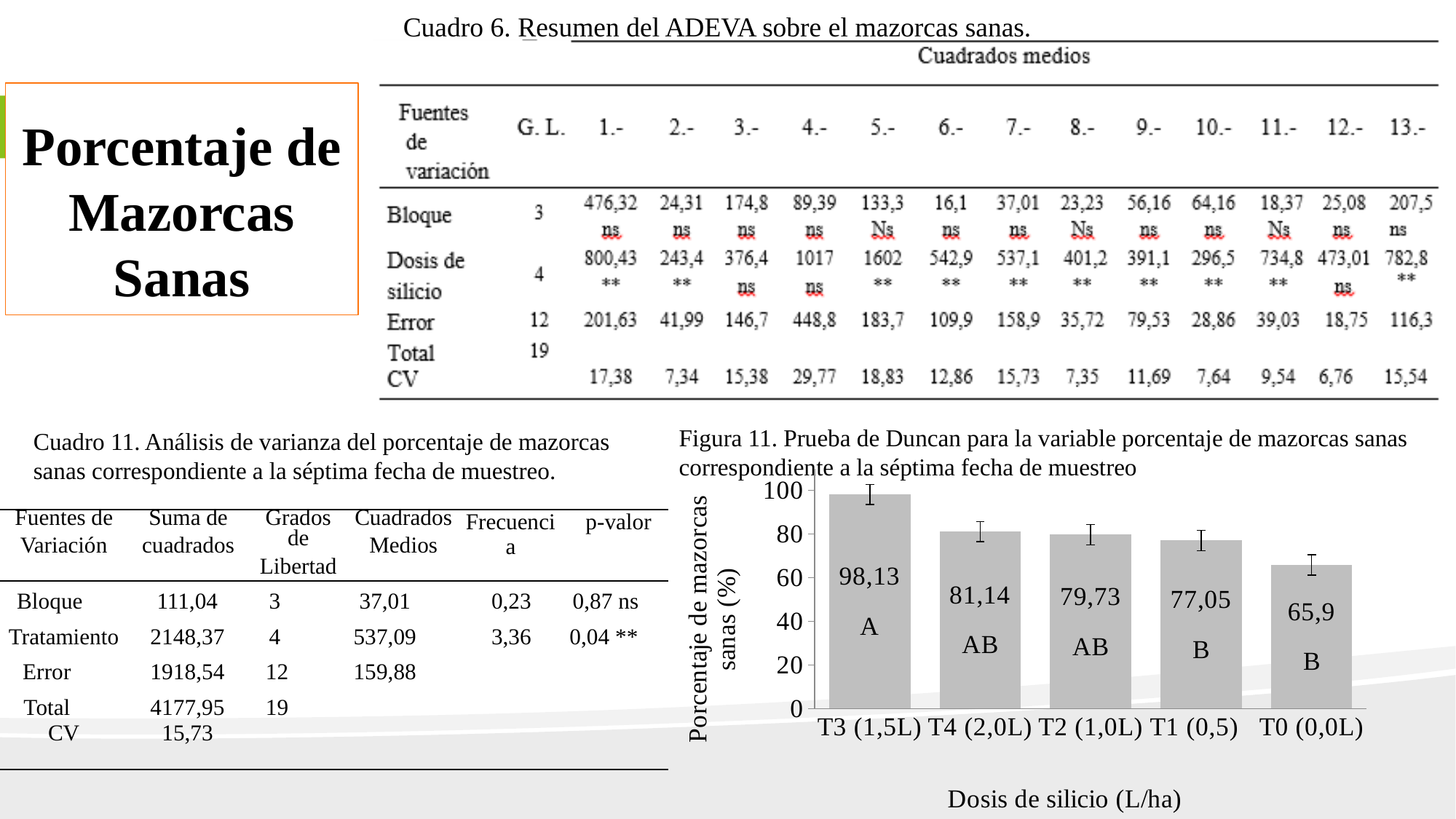
In Figura 11, do the values rise or fall from left to right along the x axis? fall In Figura 11, which is larger, the value for T1 (0,5) or the value for T0 (0,0L)? T1 (0,5) In Figura 11, what is the difference between the values for T3 (1,5L) and T4 (2,0L)? 16,99 In Figura 11, which dose has the highest percentage of healthy cobs? T3 (1,5L) How many bars are shown in Figura 11? 5 In Figura 11, what is the value for T3 (1,5L)? 98,13 In Figura 11, is the value for T0 (0,0L) greater or less than 80? less In Figura 11, which dose has the lowest percentage of healthy cobs? T0 (0,0L) In Figura 11, what is the difference between the values for T3 (1,5L) and T0 (0,0L)? 32,23 In Figura 11, what is the value for T2 (1,0L)? 79,73 What kind of chart is Figura 11? bar chart In Figura 11, what is the value for T0 (0,0L)? 65,9